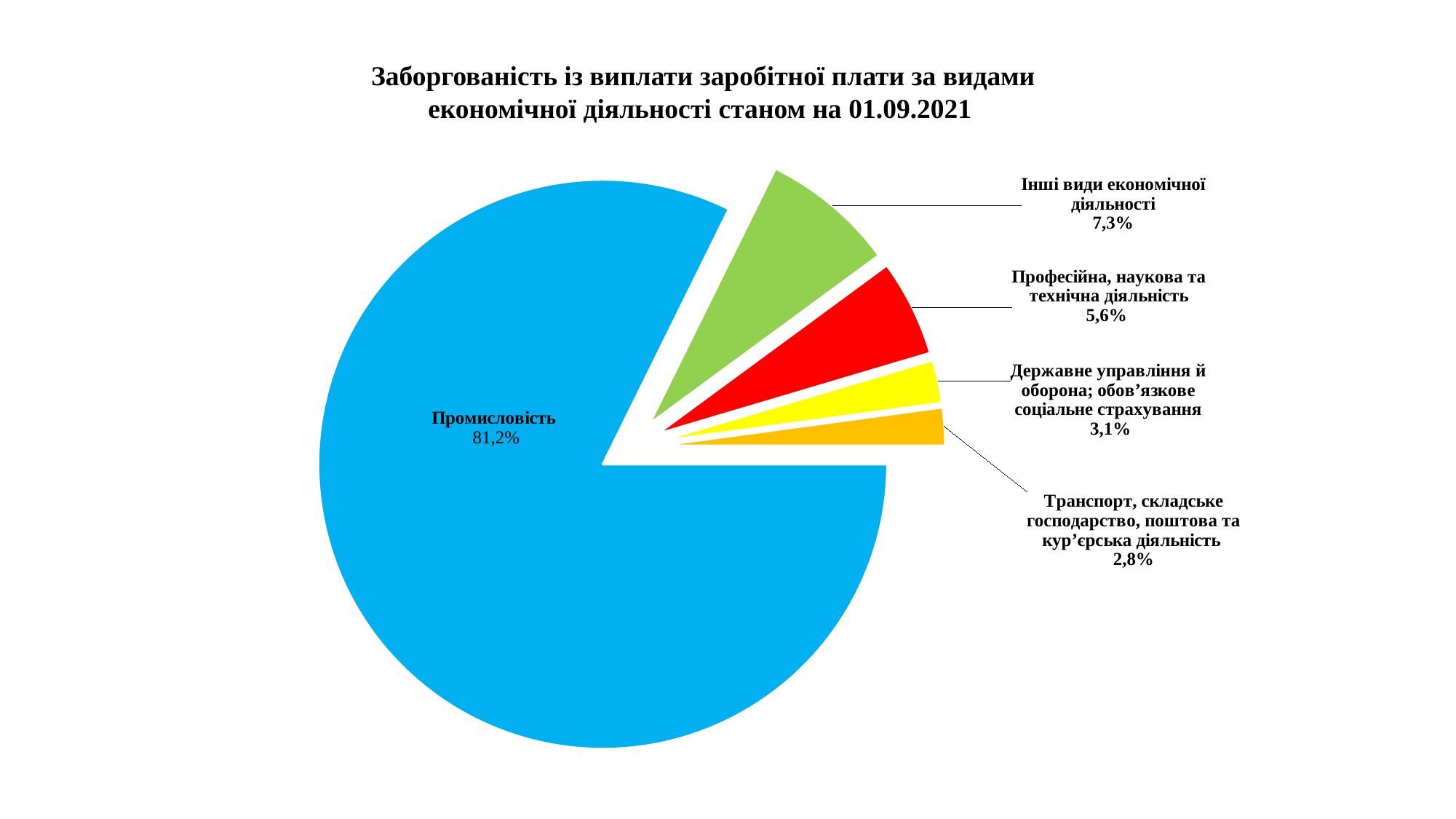
What is the value shown for Професійна, наукова та технічна діяльність? 5,6% What is the value shown for Державне управління й оборона; обов’язкове соціальне страхування? 3,1% What type of chart is shown on the slide? pie chart What is the difference between the shares of Інші види економічної діяльності and Професійна, наукова та технічна діяльність? 1,7% What is the value shown for Інші види економічної діяльності? 7,3% Which category has the smallest slice of the pie? Транспорт, складське господарство, поштова та кур’єрська діяльність What is the value shown for Транспорт, складське господарство, поштова та кур’єрська діяльність? 2,8% How many slices does the pie chart have? 5 What share of the pie does Промисловість have? 81,2% Which category has the largest slice of the pie? Промисловість What colour is the slice for Промисловість? blue Which is larger: the share of Державне управління й оборона; обов’язкове соціальне страхування or the share of Транспорт, складське господарство, поштова та кур’єрська діяльність? Державне управління й оборона; обов’язкове соціальне страхування